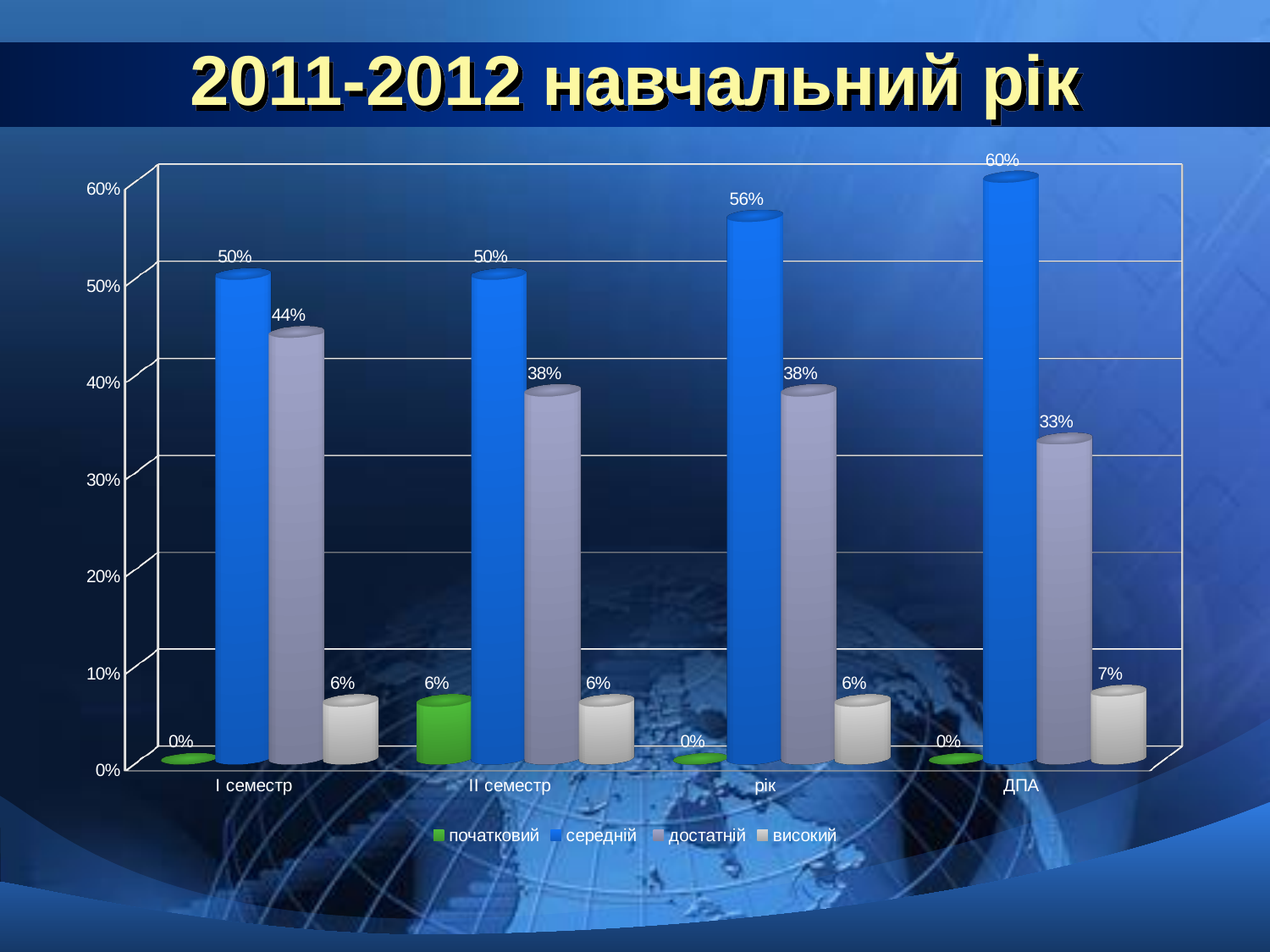
What is the value for достатній in the І семестр category? 44% What kind of chart is shown on the slide? bar chart What is the value for високий in the ДПА category? 7% How many series does the legend list? 4 What is the difference between середній and достатній in the рік category? 18% In which category is the достатній series lowest? ДПА What is the value for початковий in the ІІ семестр category? 6% What is the value for середній in the ДПА category? 60% Which is larger: середній in І семестр or середній in рік? середній in рік In which category is the середній series highest? ДПА What is the title of the slide? 2011-2012 навчальний рік How many categories are shown on the x axis? 4